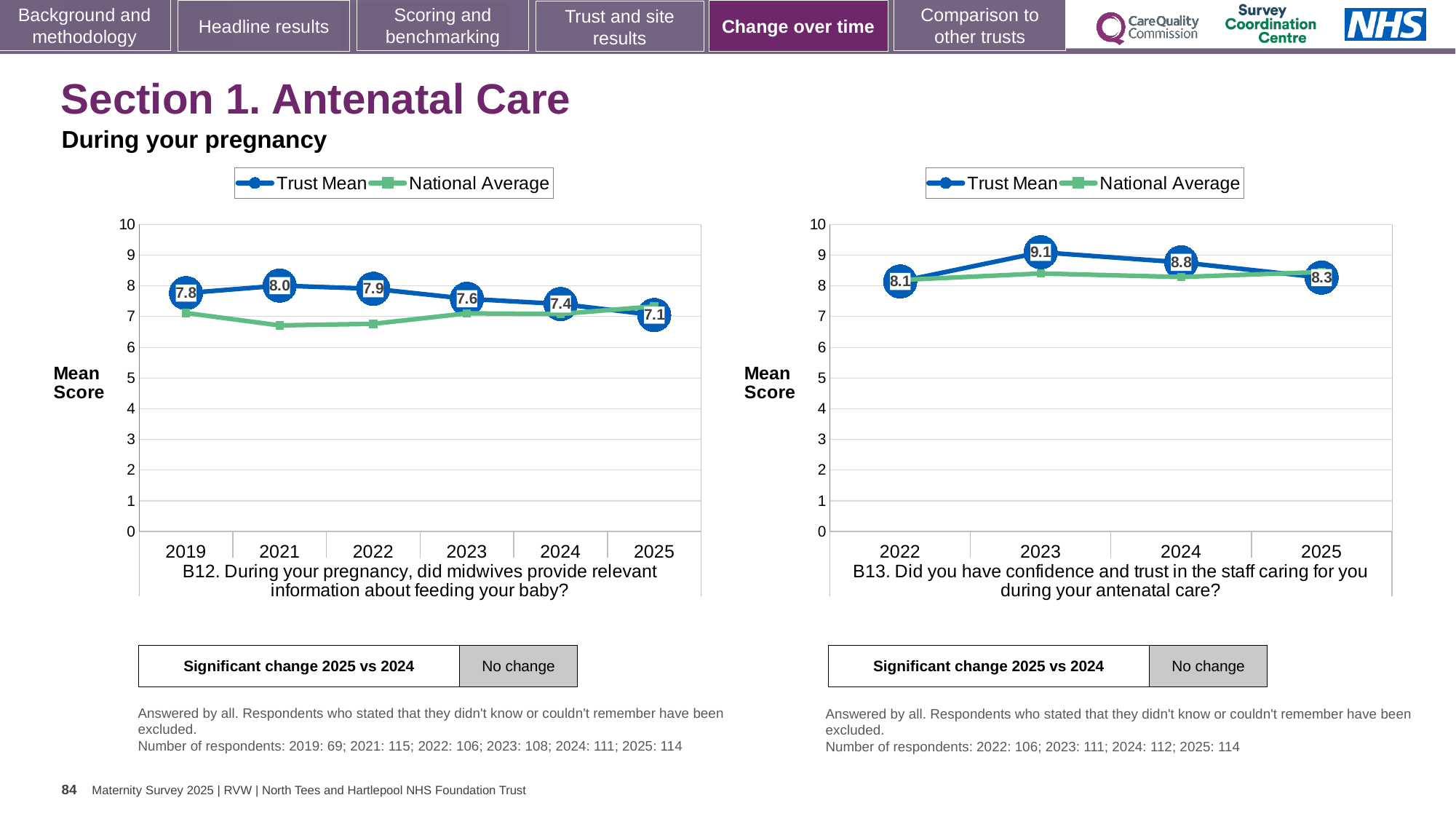
In the B13 chart (right), is the Trust Mean higher in 2022 or in 2024? 2024 How many years are shown on the x axis of the B13 chart (right)? 4 How many series does the legend of the B12 chart (left) list? 2 In the B12 chart (left), what is the Trust Mean for 2021? 8.0 In the B13 chart (right), what is the Trust Mean for 2023? 9.1 What type of chart is the B12 chart (left)? Line chart In the B12 chart (left), what is the Trust Mean for 2025? 7.1 In the B13 chart (right), which year has the highest Trust Mean? 2023 In the B12 chart (left), is the National Average for 2021 greater or less than 7? less In the B12 chart (left), which year has the lowest Trust Mean? 2025 In the B12 chart (left), what is the difference between the Trust Mean in 2019 and in 2025? 0.7 In the B13 chart (right), what is the difference between the Trust Mean in 2023 and in 2025? 0.8